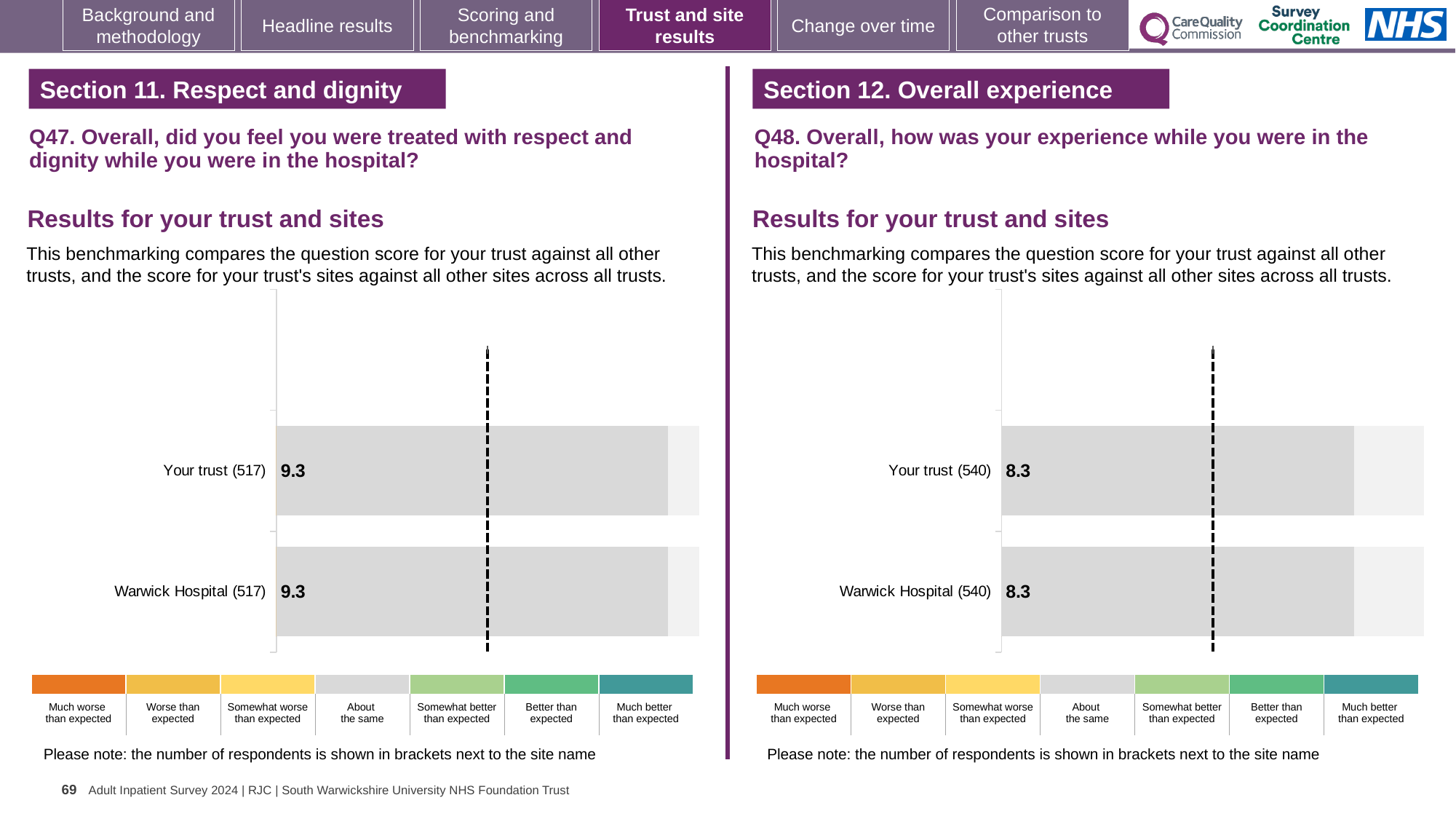
In the Section 11 chart on the left (Q47), what is the score for Warwick Hospital? 9.3 In the Section 11 chart on the left (Q47), how many respondents are shown in brackets next to Warwick Hospital? 517 In the Section 12 chart on the right (Q48), how many respondents are shown in brackets next to Your trust? 540 In the Section 11 chart on the left (Q47), what is the difference between the score for Your trust and the score for Warwick Hospital? 0.0 In the Section 11 chart on the left (Q47), what is the score for Your trust? 9.3 In the Section 12 chart on the right (Q48), what is the score for Warwick Hospital? 8.3 How many bars are plotted in the Section 12 chart on the right (Q48)? 2 What kind of chart is used in the Section 12 chart on the right (Q48)? Bar chart How many bars are plotted in the Section 11 chart on the left (Q47)? 2 In the Section 12 chart on the right (Q48), what is the score for Your trust? 8.3 Is the Your trust score in the Section 11 chart on the left (Q47) larger or smaller than the Your trust score in the Section 12 chart on the right (Q48)? Larger In the Section 12 chart on the right (Q48), what is the difference between the score for Your trust and the score for Warwick Hospital? 0.0